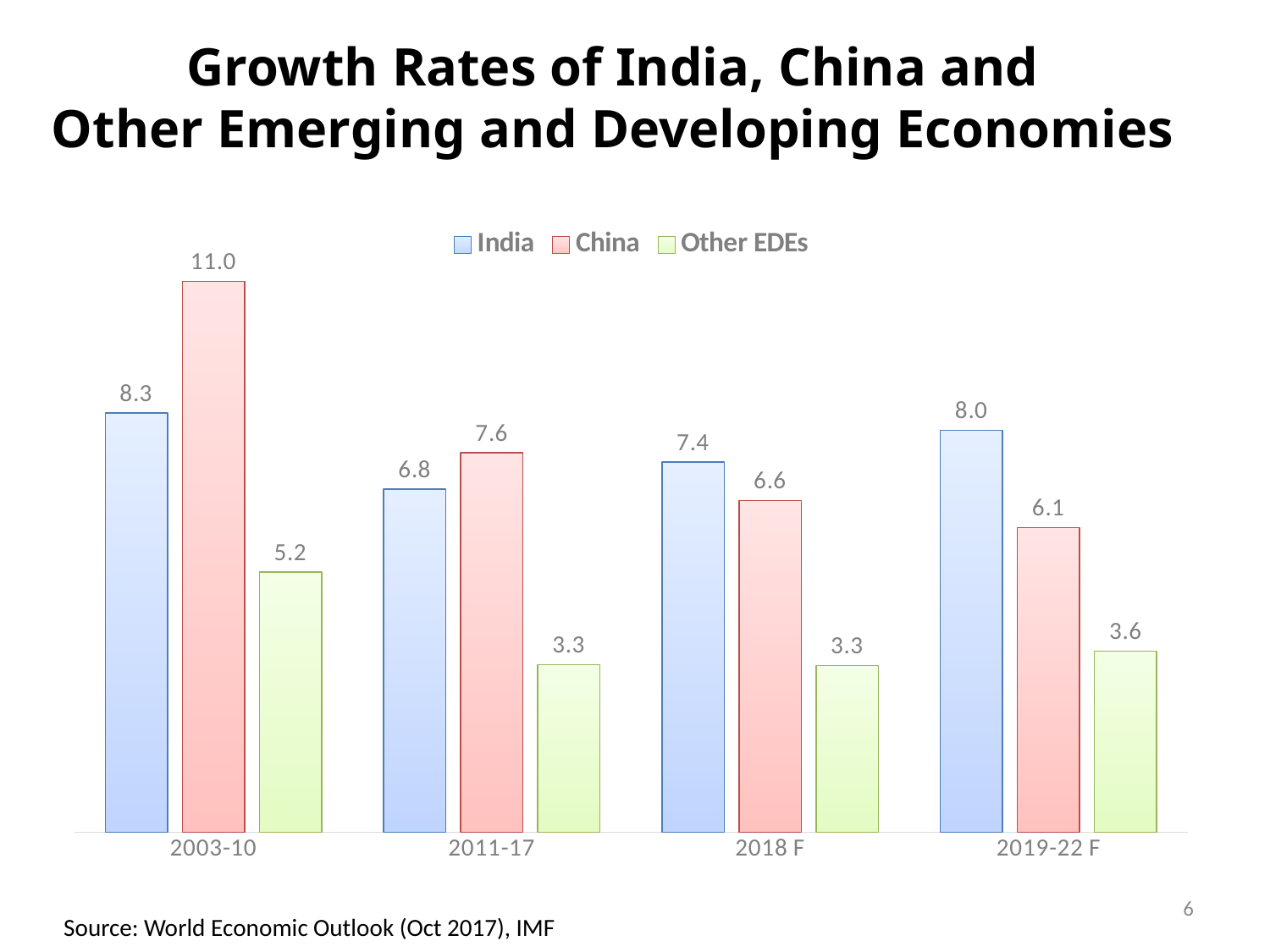
How many periods are shown on the x axis? 4 In which period is India's growth rate lowest? 2011-17 What is the growth rate for Other EDEs in 2018 F? 3.3 What is the difference between China's and India's growth rates in 2003-10? 2.7 What kind of chart is shown on the slide? Bar chart Which has the higher growth rate in 2018 F, India or China? India What is the difference between India's and China's growth rates in 2019-22 F? 1.9 Does China's growth rate rise or fall from 2003-10 to 2019-22 F? Fall What is the growth rate for China in 2003-10? 11.0 What is the growth rate for India in 2019-22 F? 8.0 How many series does the legend list? 3 In which period is China's growth rate highest? 2003-10